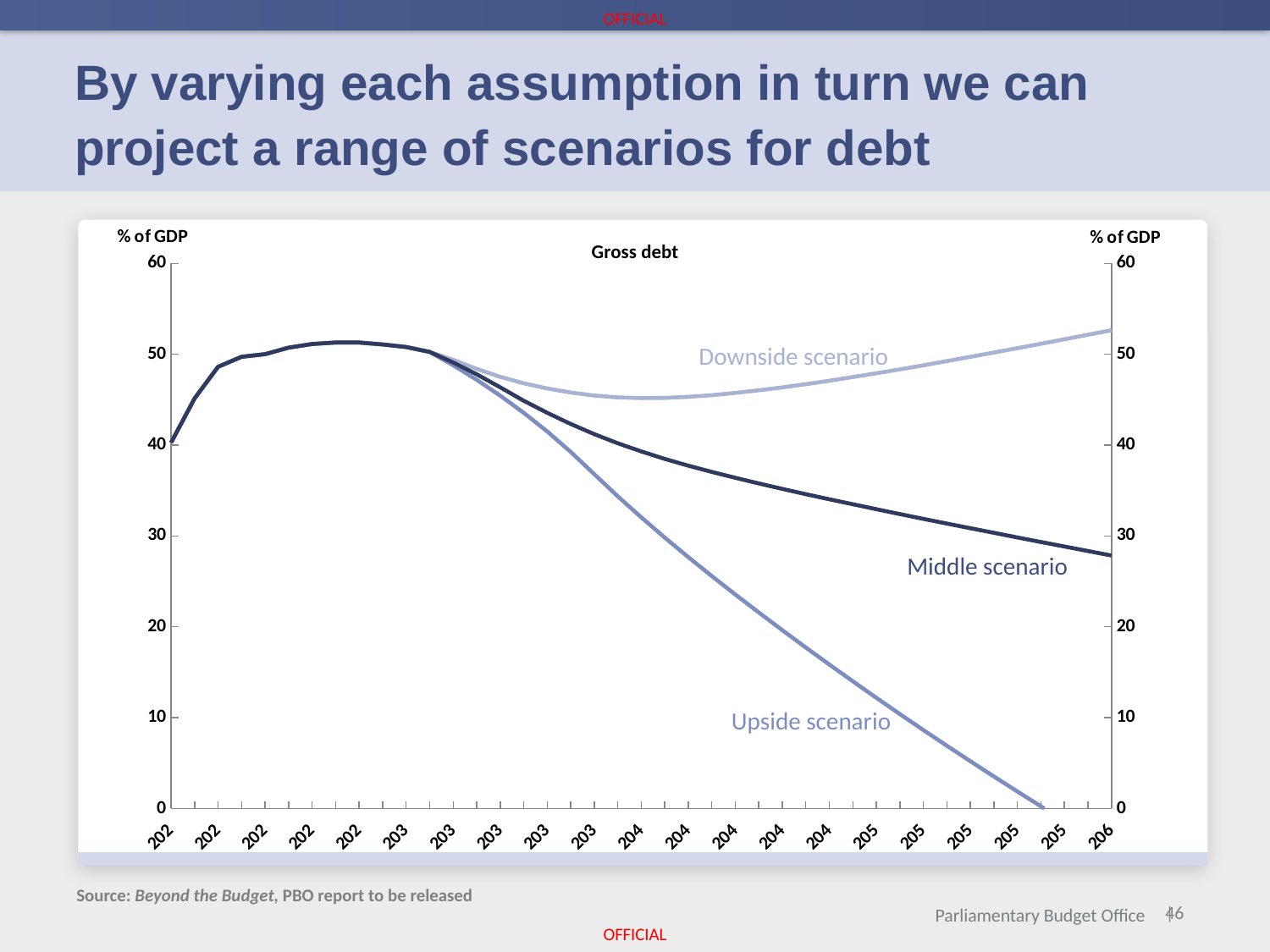
Is the value of the Downside scenario at the right-hand end of the chart greater or less than 50? greater At the right-hand end of the chart, which is larger: the Middle scenario or the Downside scenario? Downside scenario After the peak, does the Upside scenario line rise or fall as it moves to the right? Fall Which scenario has the highest value at the right-hand end of the chart? Downside scenario How many scenario lines are plotted on the chart? 3 Is the value of the Middle scenario at the right-hand end of the chart greater or less than 30? less Is the lowest point of the Downside scenario greater or less than 40? greater What kind of chart is shown on the slide? Line chart What unit is shown on the vertical axis of the chart? % of GDP Which scenario has the lowest value at the right-hand end of the chart? Upside scenario What is the title of the chart? Gross debt